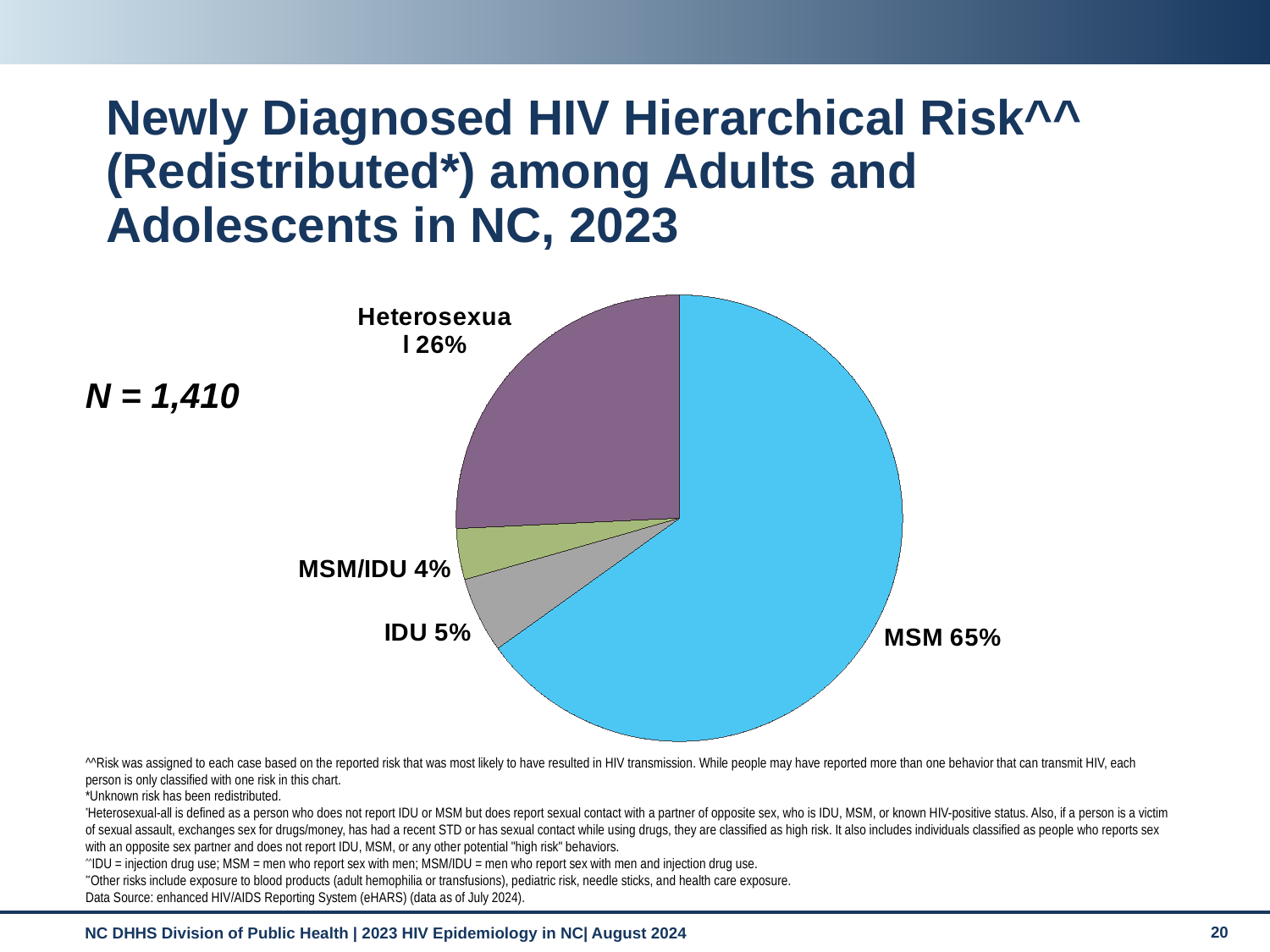
What percentage of newly diagnosed HIV cases is attributed to Heterosexual risk? 26% What is the total N shown on the slide for the pie chart? 1,410 How many risk categories are shown in the pie chart? 4 Which risk category has the largest share of the pie? MSM What is the difference in percentage points between the MSM and Heterosexual slices? 39 What percentage of newly diagnosed HIV cases is attributed to MSM? 65% What percentage of newly diagnosed HIV cases is attributed to IDU? 5% What percentage of newly diagnosed HIV cases is attributed to MSM/IDU? 4% Which is larger, the IDU slice or the MSM/IDU slice? IDU What type of chart is shown on the slide? pie chart What colour is the MSM slice of the pie chart? light blue Which risk category has the smallest share of the pie? MSM/IDU